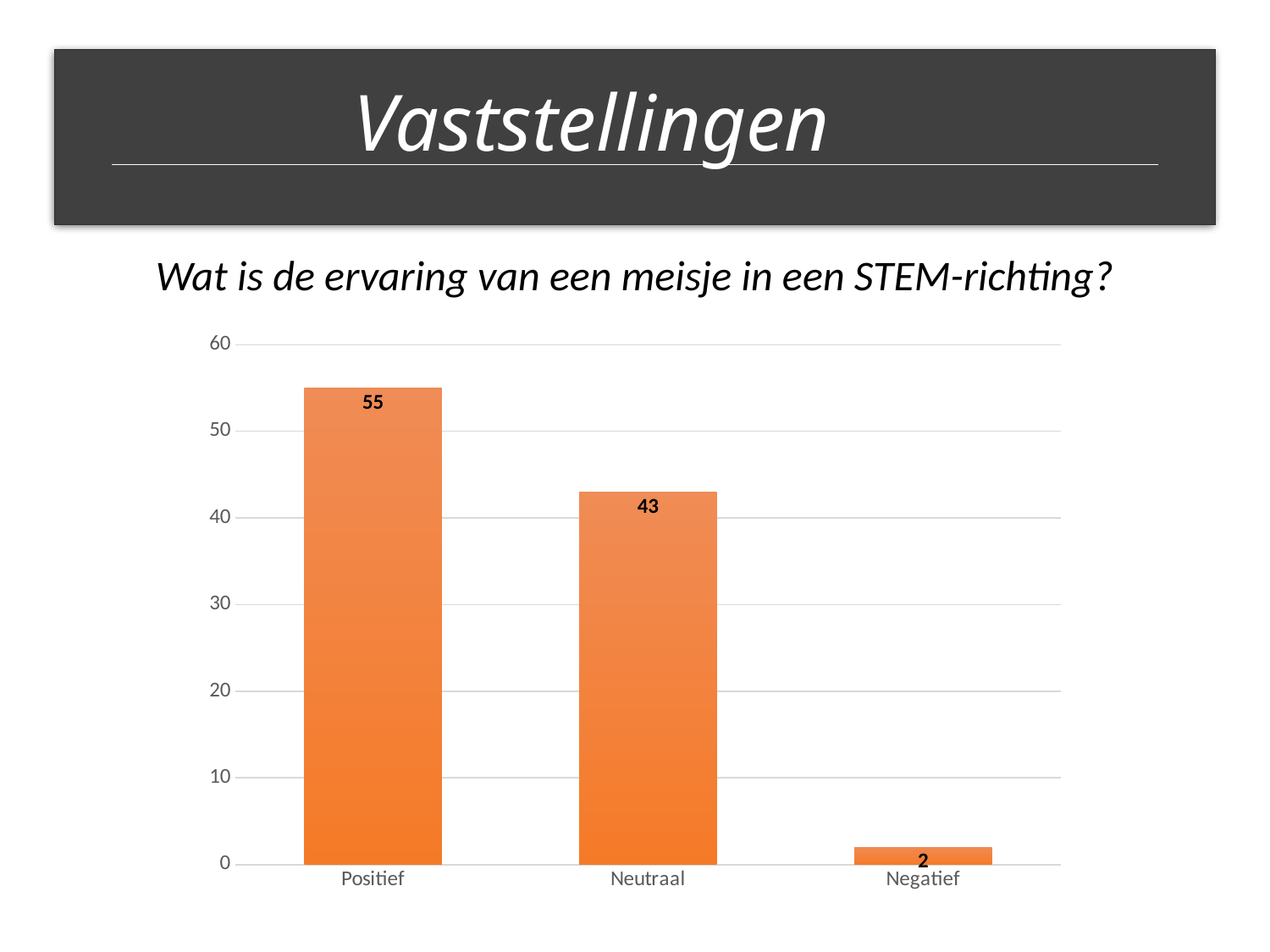
Which category has the lowest value? Negatief What is the value for Neutraal? 43 Is the value for Neutraal greater or less than 40? greater What kind of chart is shown on the slide? bar chart What is the value for Negatief? 2 How many categories are shown on the x axis? 3 What question is written above the chart? Wat is de ervaring van een meisje in een STEM-richting? Which is larger, the value for Neutraal or the value for Negatief? Neutraal What is the value for Positief? 55 What is the difference between the values for Neutraal and Negatief? 41 What is the difference between the values for Positief and Neutraal? 12 Which category has the highest value? Positief